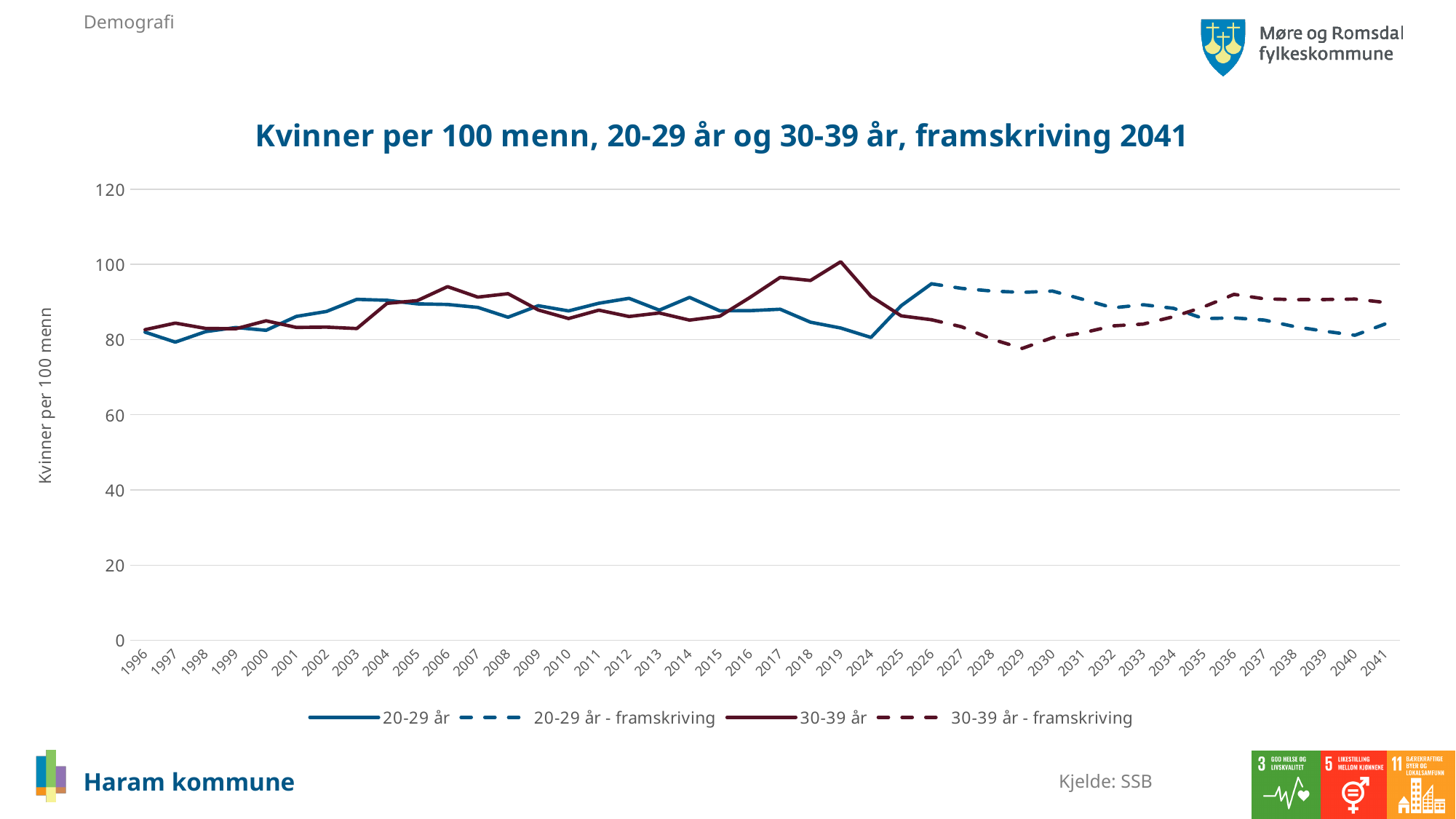
Does the 30-39 år - framskriving series rise or fall between 2029 and 2036? rise What kind of chart is shown on the slide? line chart In which year does the 20-29 år series reach its highest value? 2026 How many series does the legend list? 4 In 2019, which series has the larger value, 20-29 år or 30-39 år? 30-39 år In which year does the 30-39 år - framskriving series reach its lowest value? 2029 In which year does the 30-39 år series reach its highest value? 2019 Is the value for 30-39 år - framskriving in 2029 greater or less than 80? less What is the title of the chart? Kvinner per 100 menn, 20-29 år og 30-39 år, framskriving 2041 Is the value for 20-29 år in 2026 greater or less than 90? greater What is the label on the vertical axis? Kvinner per 100 menn In 2029, which projection series has the larger value, 20-29 år - framskriving or 30-39 år - framskriving? 20-29 år - framskriving